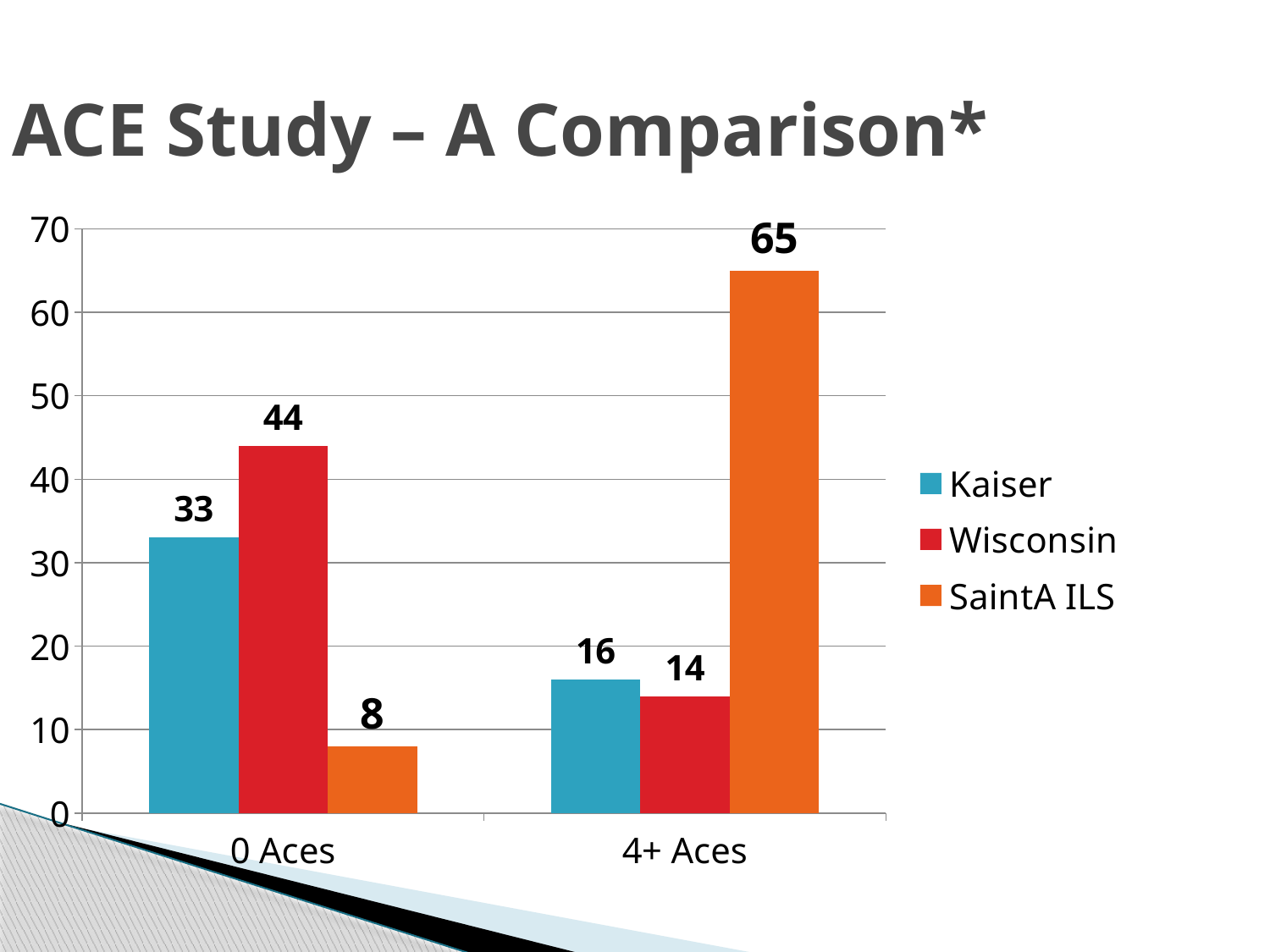
What is the value for Kaiser in the 0 Aces category? 33 What is the difference between the SaintA ILS values for 4+ Aces and 0 Aces? 57 Which series has the lowest value in the 0 Aces category? SaintA ILS What is the title of the slide? ACE Study – A Comparison* What kind of chart is shown on the slide? bar chart Is the value for Wisconsin in the 0 Aces category greater or less than 40? greater How many categories are shown on the x axis? 2 What is the value for SaintA ILS in the 4+ Aces category? 65 How many series does the legend list? 3 Which series has the highest value in the 4+ Aces category? SaintA ILS Which is larger in the 4+ Aces category, Kaiser or Wisconsin? Kaiser What is the value for Wisconsin in the 0 Aces category? 44